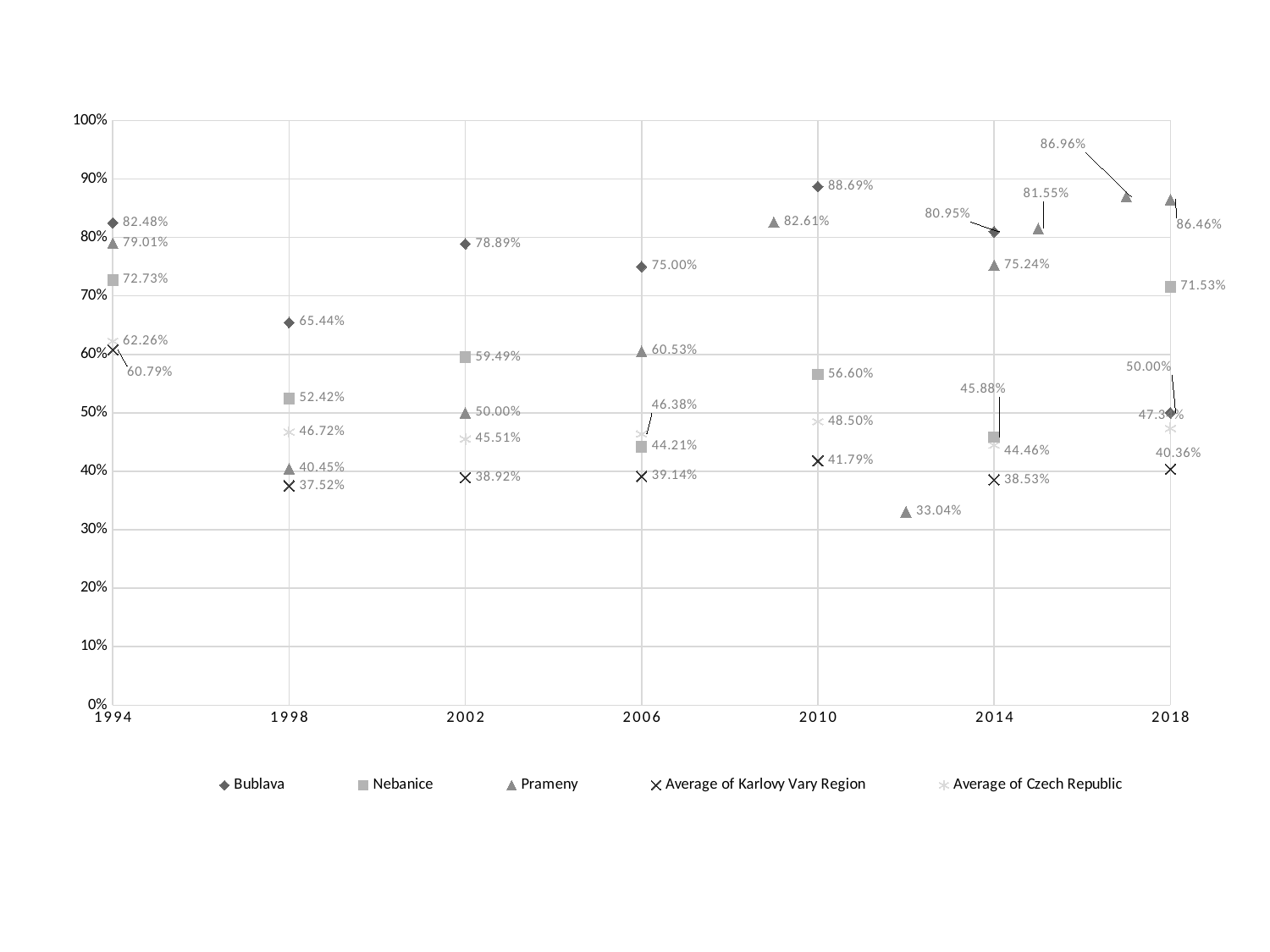
How many series does the legend list? 5 Which is larger in 2006, Bublava or Prameny? Bublava What is the value for Bublava in 2010? 88.69% Is the value for Nebanice in 2006 greater or less than 50%? less What kind of chart is this? scatter chart What is the lowest value shown for Prameny? 33.04% Does the value for Bublava rise or fall from 2014 to 2018? fall In which year does Bublava reach its highest value? 2010 What is the difference between Bublava and Nebanice in 1994? 9.75% What is the value for Average of Czech Republic in 2010? 48.50% What is the value for Nebanice in 2018? 71.53% What is the value for Average of Karlovy Vary Region in 1998? 37.52%